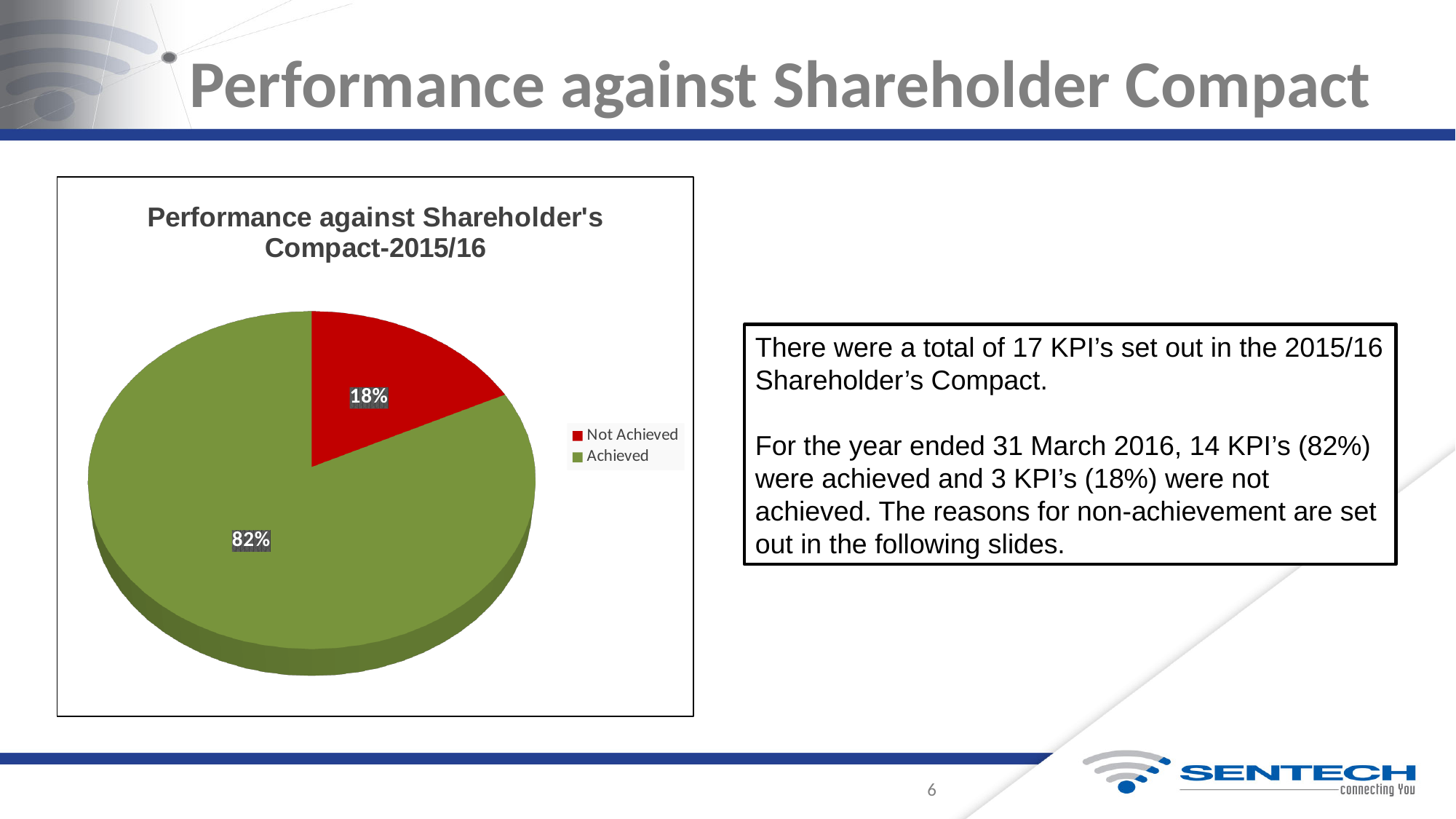
What is the difference in percentage points between the Achieved and Not Achieved slices? 64 What share of the pie is labelled Not Achieved? 18% How many slices does the pie chart have? 2 What is the title of the chart? Performance against Shareholder's Compact-2015/16 Which is larger, the Achieved slice or the Not Achieved slice? Achieved What is the total of the two slice percentages shown on the pie? 100% What type of chart is shown on the slide? Pie chart Which slice of the pie is the largest? Achieved How many entries does the legend list? 2 Which slice of the pie is the smallest? Not Achieved What colour is the Not Achieved slice? Red What share of the pie is labelled Achieved? 82%